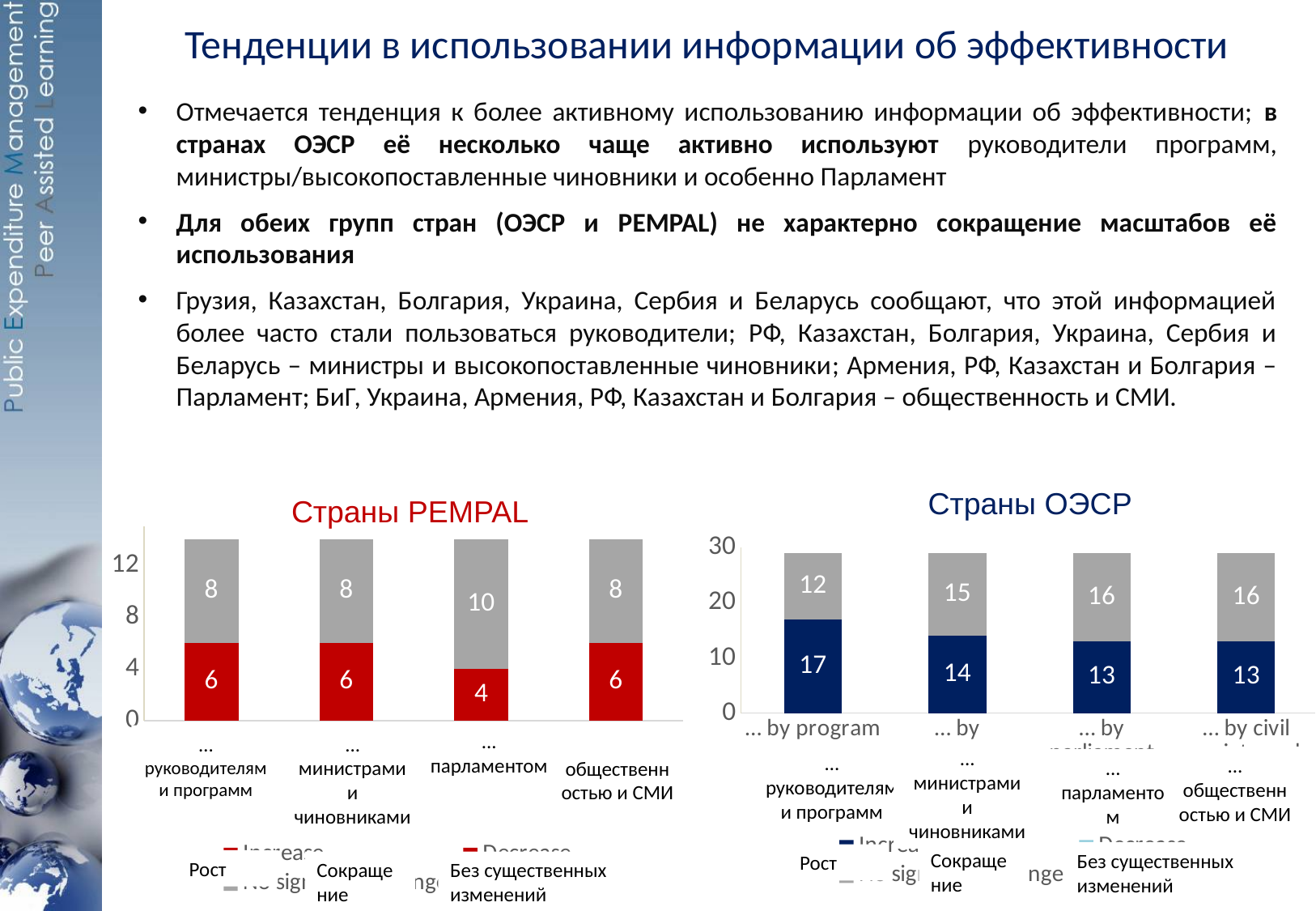
In the 'Страны ОЭСР' chart, what is the value of the grey segment for '… общественностью и СМИ'? 16 In the 'Страны PEMPAL' chart, which category has the lowest red segment value? парламентом What type of chart is the 'Страны ОЭСР' chart? stacked bar chart In the 'Страны PEMPAL' chart, what is the total of the stacked bar for 'парламентом'? 14 In the 'Страны PEMPAL' chart, what is the value of the grey segment for 'парламентом'? 10 In the 'Страны PEMPAL' chart, what is the value of the red (Рост) segment for 'парламентом'? 4 In the 'Страны ОЭСР' chart, which category has the highest dark blue segment value? … руководителями программ How many categories are shown on the x axis of the 'Страны PEMPAL' chart? 4 In the 'Страны ОЭСР' chart, what is the total of the stacked bar for '… министрами и чиновниками'? 29 In the 'Страны ОЭСР' chart, what is the difference between the dark blue values for '… руководителями программ' and '… парламентом'? 4 In the 'Страны ОЭСР' chart, is the dark blue value for '… министрами и чиновниками' larger or smaller than the grey value for the same category? smaller In the 'Страны ОЭСР' chart, what is the value of the dark blue segment for '… руководителями программ'? 17